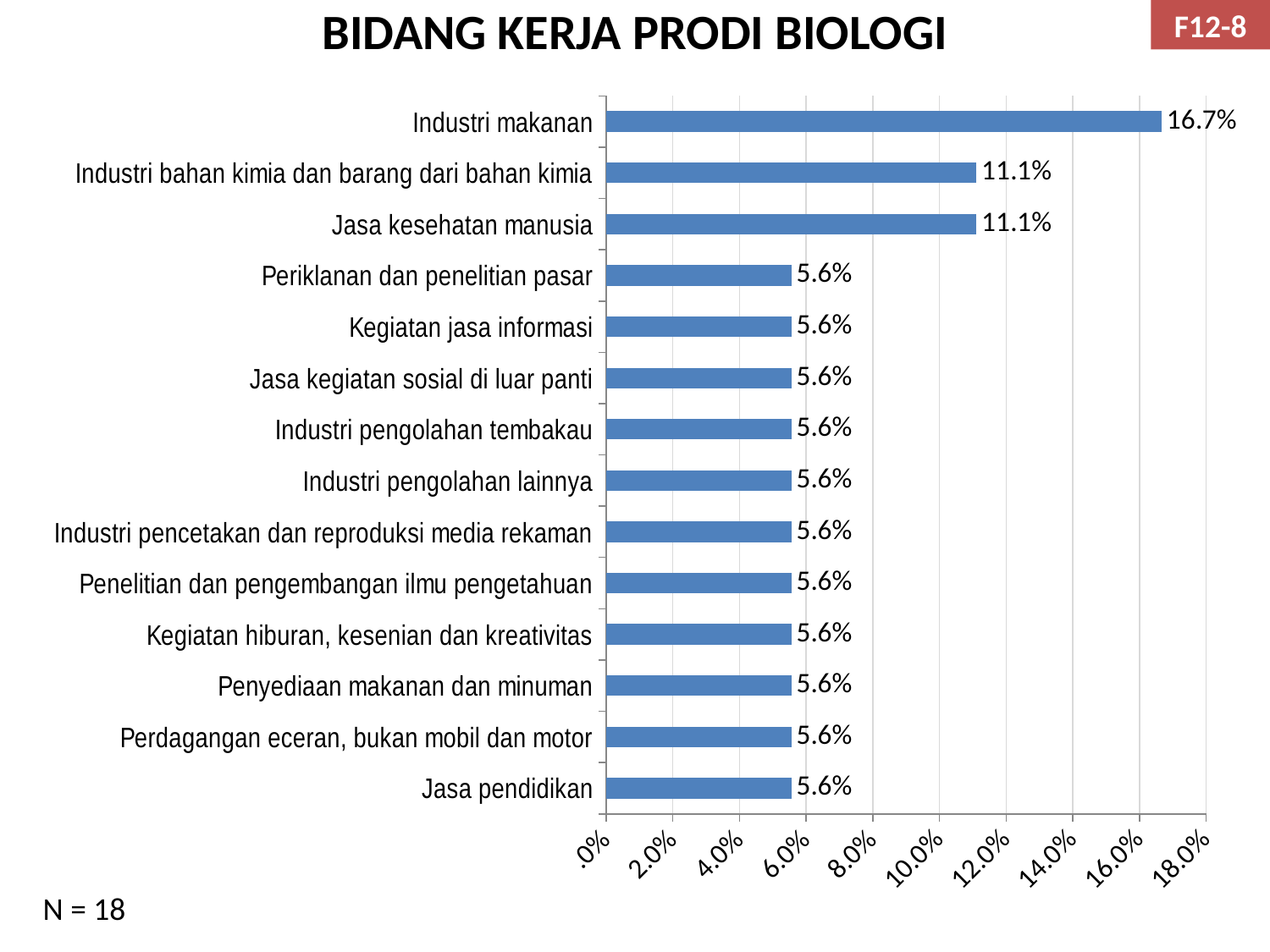
What is the difference between the values for Industri makanan and Jasa kesehatan manusia? 5.6% Which category has the highest value? Industri makanan What kind of chart is shown on the slide? bar chart What is the difference between the values for Industri bahan kimia dan barang dari bahan kimia and Periklanan dan penelitian pasar? 5.5% How many categories are shown in the chart? 14 What is the value for Industri makanan? 16.7% What is the value for Jasa kesehatan manusia? 11.1% What is the value for Jasa pendidikan? 5.6% Is the value for Industri makanan greater or less than 14.0%? greater What is the value for Industri bahan kimia dan barang dari bahan kimia? 11.1% What is the title of the chart? BIDANG KERJA PRODI BIOLOGI Which is larger, the value for Industri makanan or the value for Kegiatan jasa informasi? Industri makanan